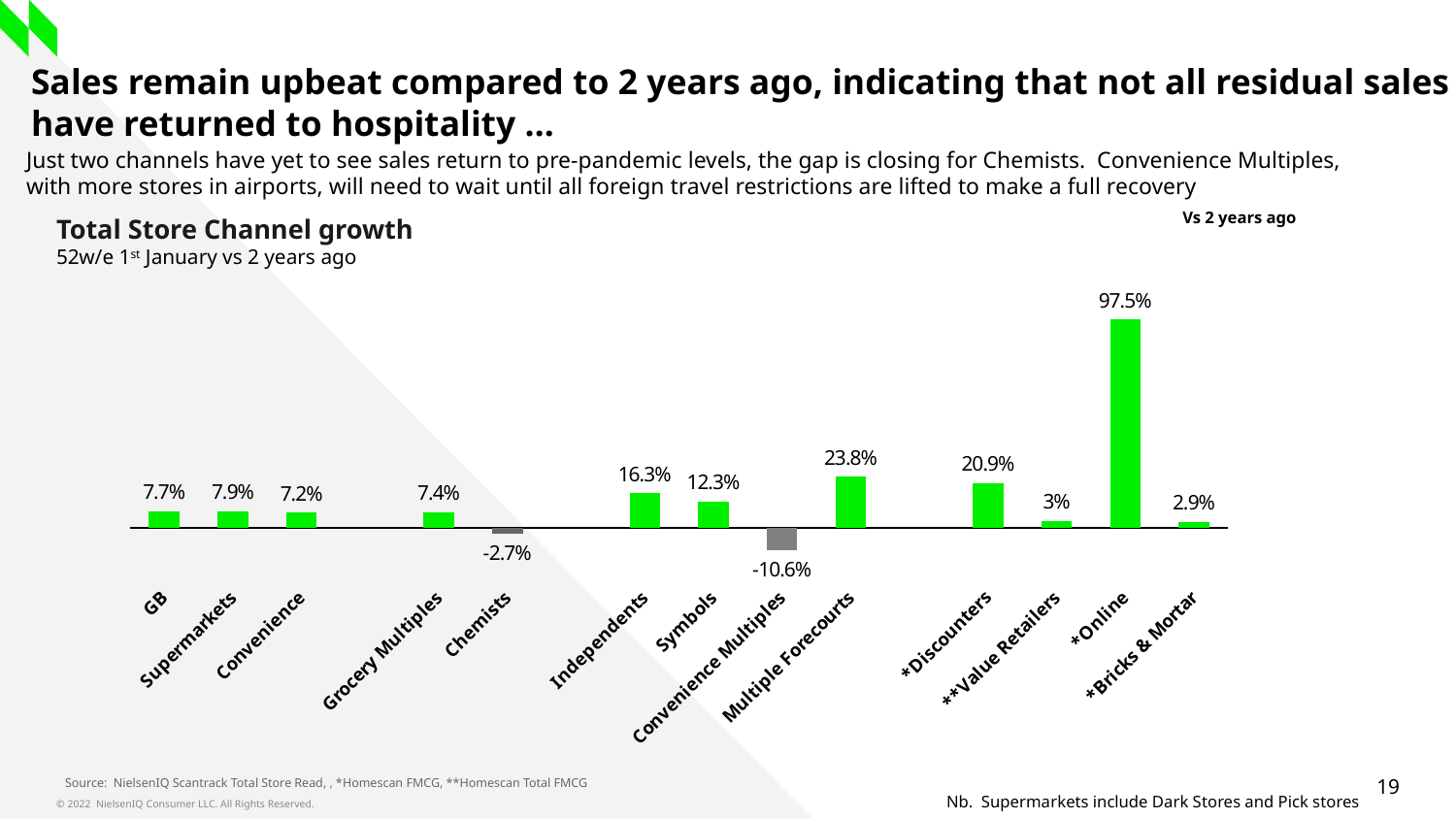
What kind of chart is the Total Store Channel growth chart? Bar chart Which channel has the highest growth in the Total Store Channel growth chart? *Online How many channels are shown in the Total Store Channel growth chart? 13 What is the difference between the values for *Discounters and **Value Retailers in the Total Store Channel growth chart? 17.9% Which is larger in the Total Store Channel growth chart, the value for Independents or the value for Symbols? Independents What period does the subtitle of the Total Store Channel growth chart state? 52w/e 1st January vs 2 years ago What is the value for Multiple Forecourts in the Total Store Channel growth chart? 23.8% Which channel has the lowest growth in the Total Store Channel growth chart? Convenience Multiples What is the value for Convenience Multiples in the Total Store Channel growth chart? -10.6% How many channels in the Total Store Channel growth chart have negative growth? 2 What is the value for Chemists in the Total Store Channel growth chart? -2.7% What is the value for *Online in the Total Store Channel growth chart? 97.5%